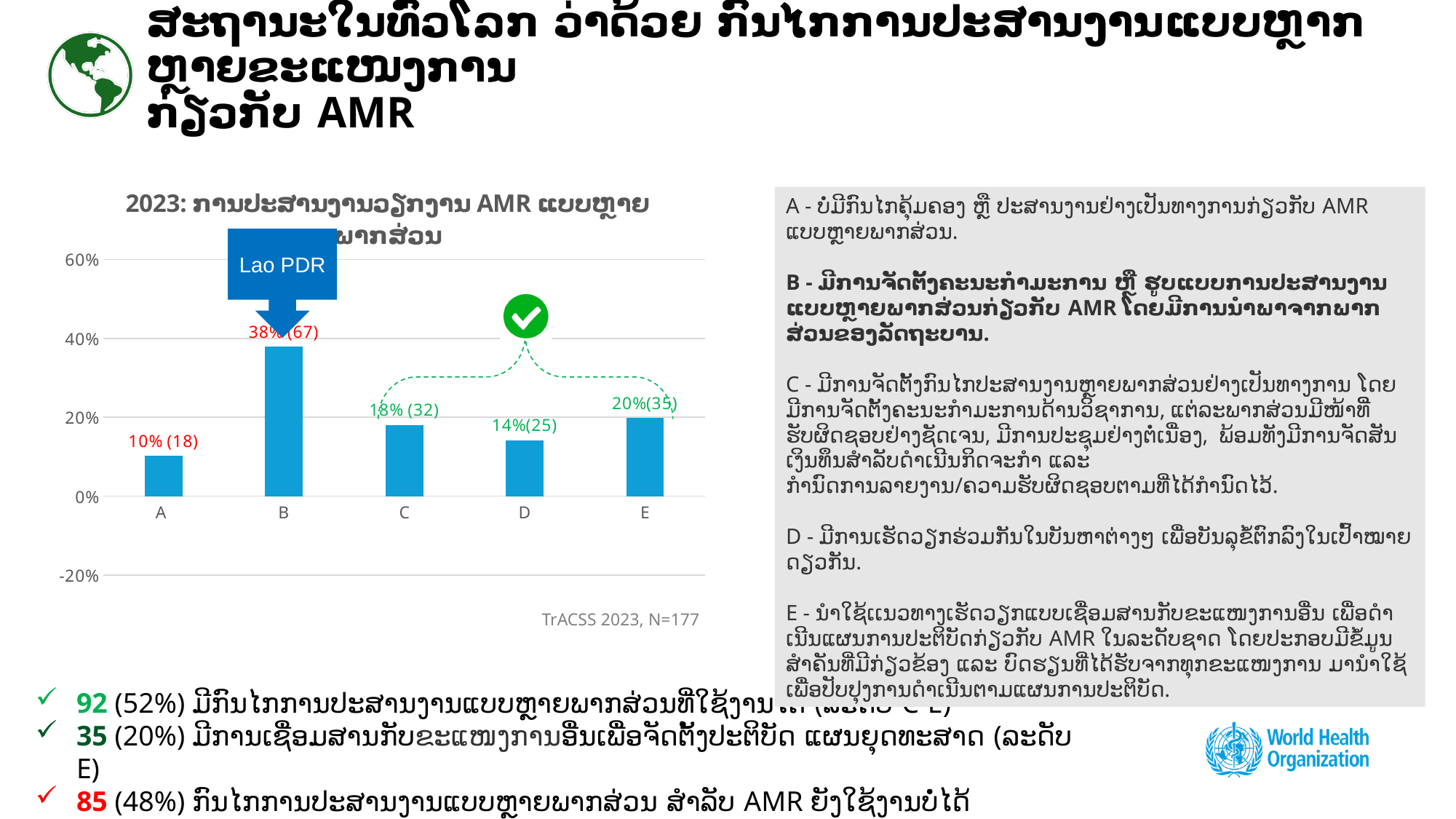
Which category has the highest value? B What is the difference in percentage points between category B and category C? 20 What is the value shown for category D? 14%(25) What is the value shown for category E? 20%(35) Which category is marked with the 'Lao PDR' arrow on the chart? B What is the value shown for category A? 10% (18) How many categories are plotted on the x axis of the chart? 5 Which category has the lowest value? A Is the value for category B greater or less than 20%? greater What is the value shown for category B? 38% (67) Which is larger, the value for category C or the value for category D? C What kind of chart is shown on the slide? bar chart